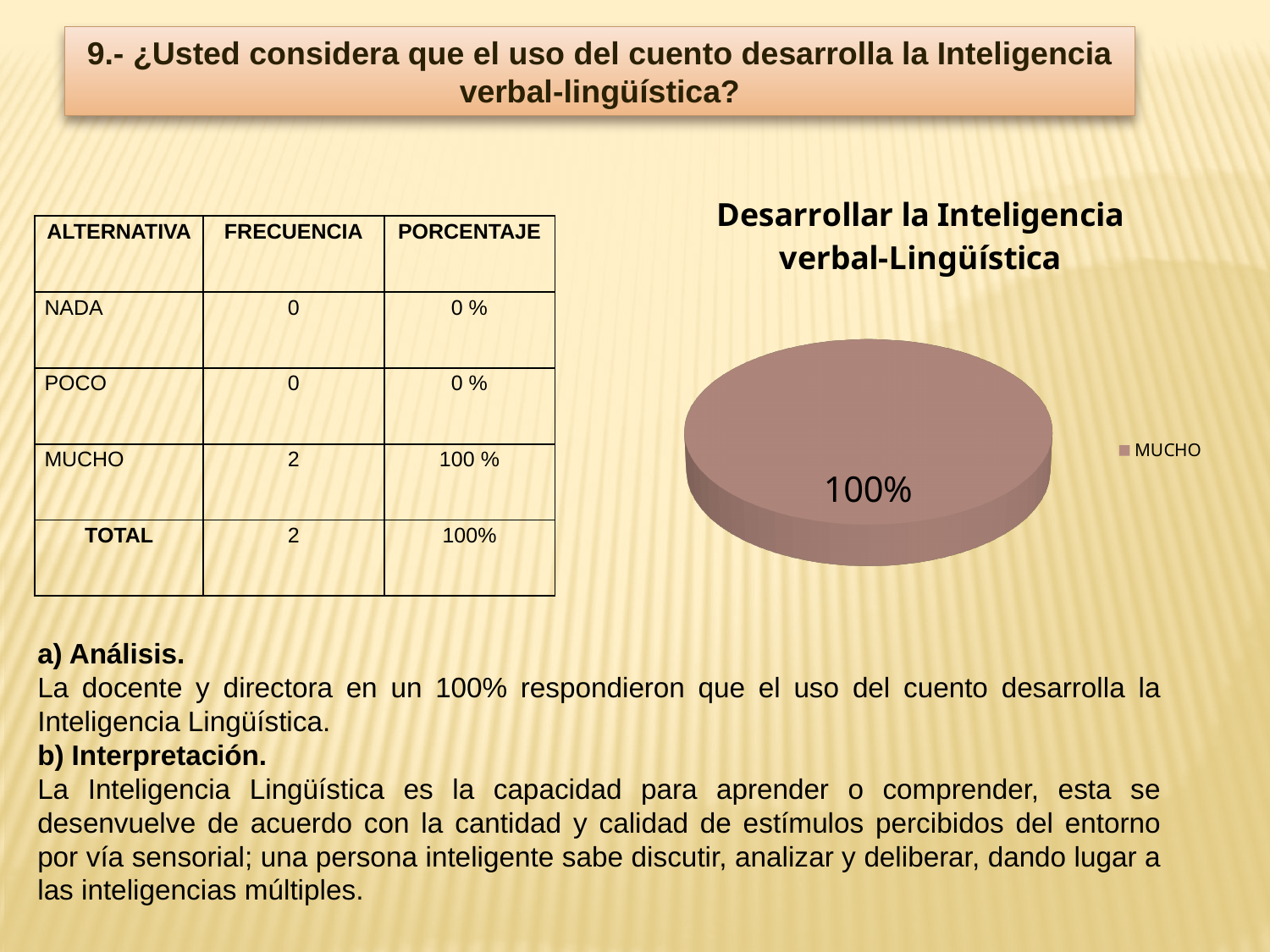
Which category is listed in the pie chart's legend? MUCHO How many slices does the pie chart have? 1 How many entries does the chart legend list? 1 Which category has the largest share of the pie chart? MUCHO What is the title of the pie chart? Desarrollar la Inteligencia verbal-Lingüística What kind of chart is shown on the slide? pie chart What percentage is shown for the MUCHO slice in the pie chart? 100% What share of the pie does the MUCHO slice represent? 100%